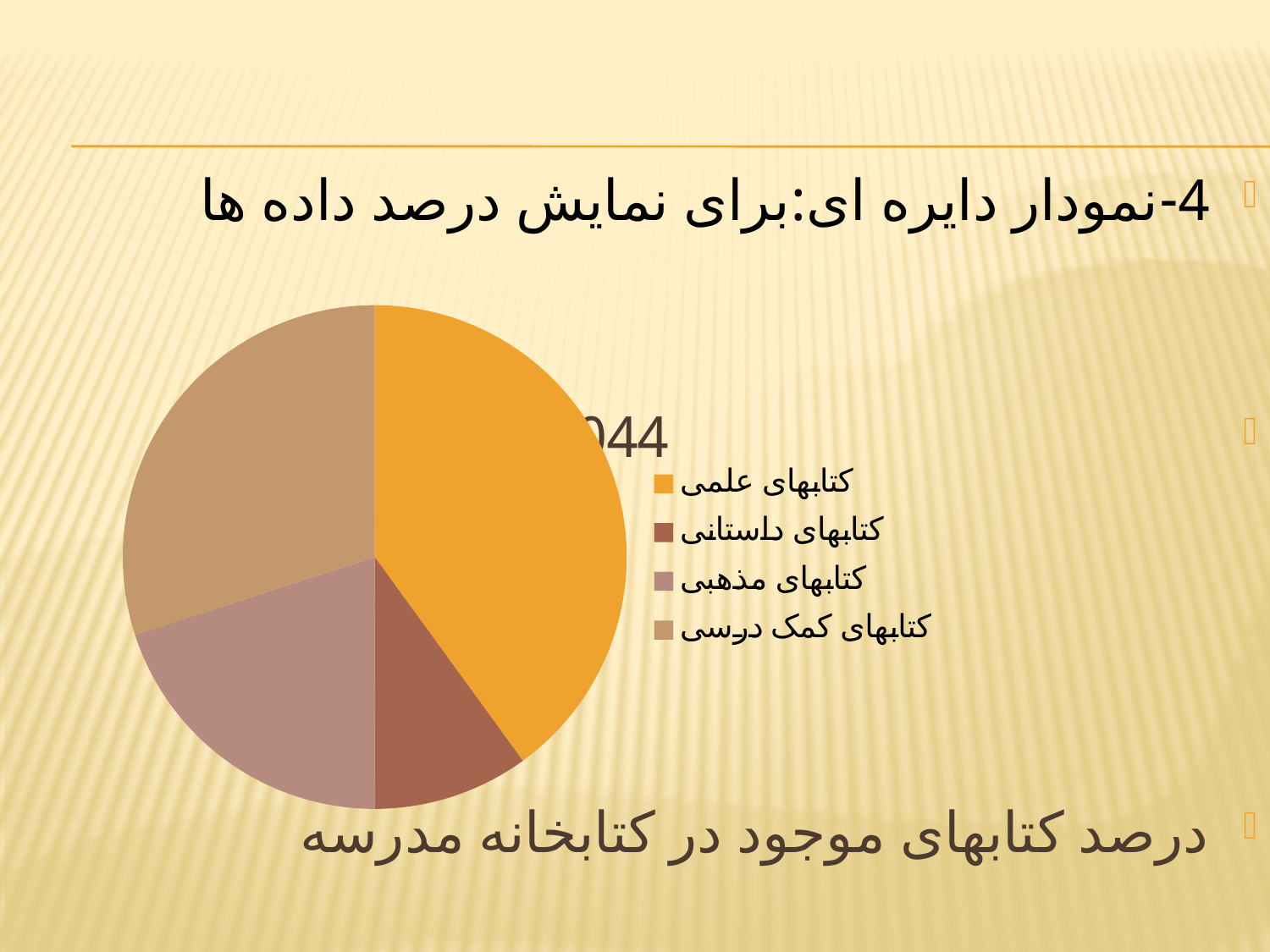
Which slice is larger: کتابهای مذهبی or کتابهای داستانی? کتابهای مذهبی What caption appears below the pie chart? درصد کتابهای موجود در کتابخانه مدرسه How many entries does the legend of the pie chart list? 4 Which category has the largest slice of the pie chart? کتابهای علمی What kind of chart is shown on the slide? pie chart Which slice is larger: کتابهای کمک درسی or کتابهای مذهبی? کتابهای کمک درسی How many slices does the pie chart have? 4 Which category has the smallest slice of the pie chart? کتابهای داستانی Which category is shown in orange in the pie chart? کتابهای علمی Which slice is larger: کتابهای علمی or کتابهای داستانی? کتابهای علمی